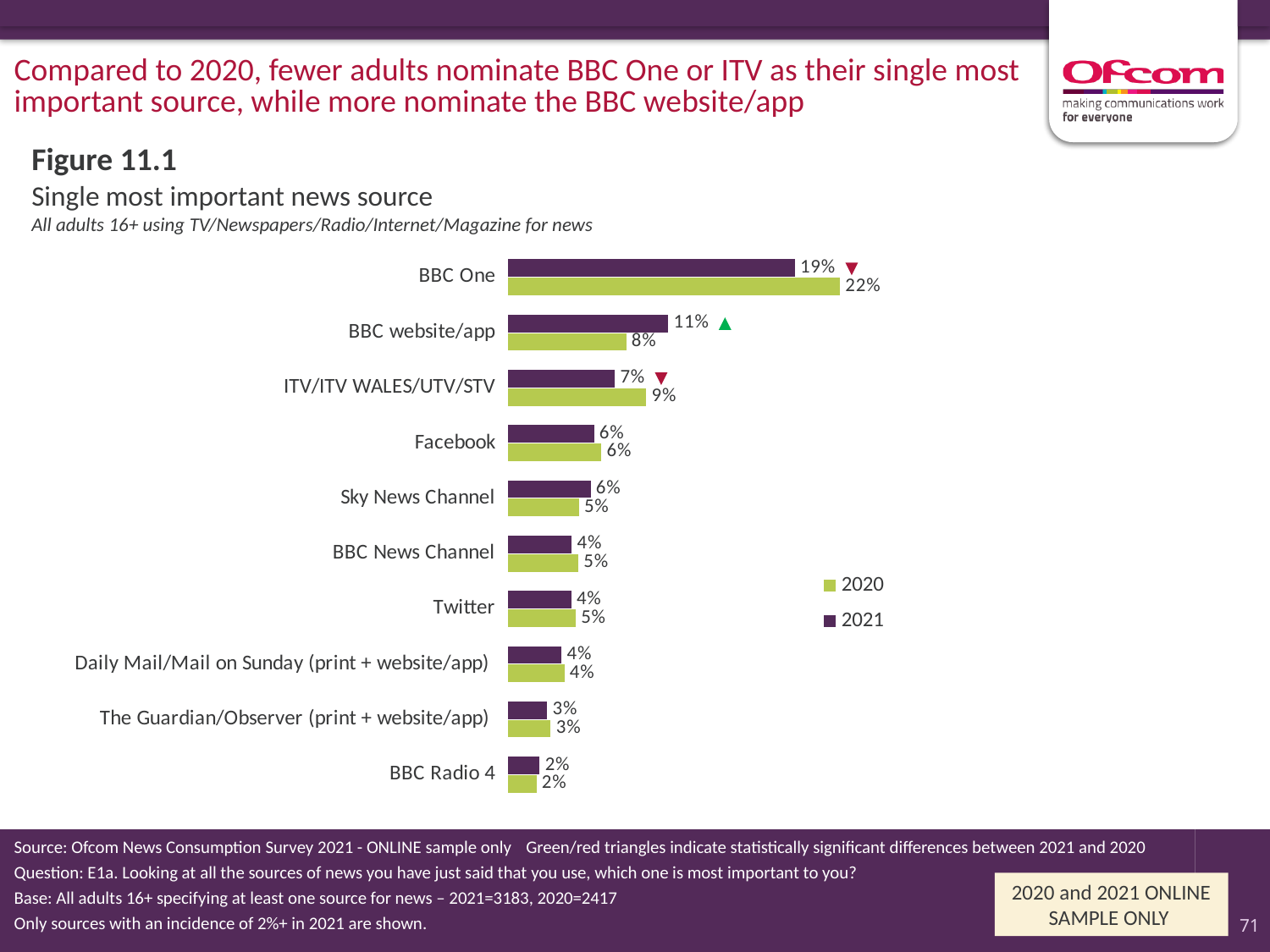
What was the 2020 value for the BBC website/app? 8% What percentage nominated ITV/ITV WALES/UTV/STV in 2020? 9% What is the difference between the 2021 and 2020 values for the BBC website/app? 3 percentage points Which news source has the highest 2021 value? BBC One Which is larger for Sky News Channel, the 2020 value or the 2021 value? 2021 By how many percentage points did the BBC One value fall from 2020 to 2021? 3 percentage points Which news source has the lowest 2020 value? BBC Radio 4 What type of chart is shown? Bar chart What percentage of adults nominated BBC One as their single most important news source in 2021? 19% Which colour represents 2021 in the chart? Purple How many series does the legend list? 2 How many news sources are shown in the chart? 10